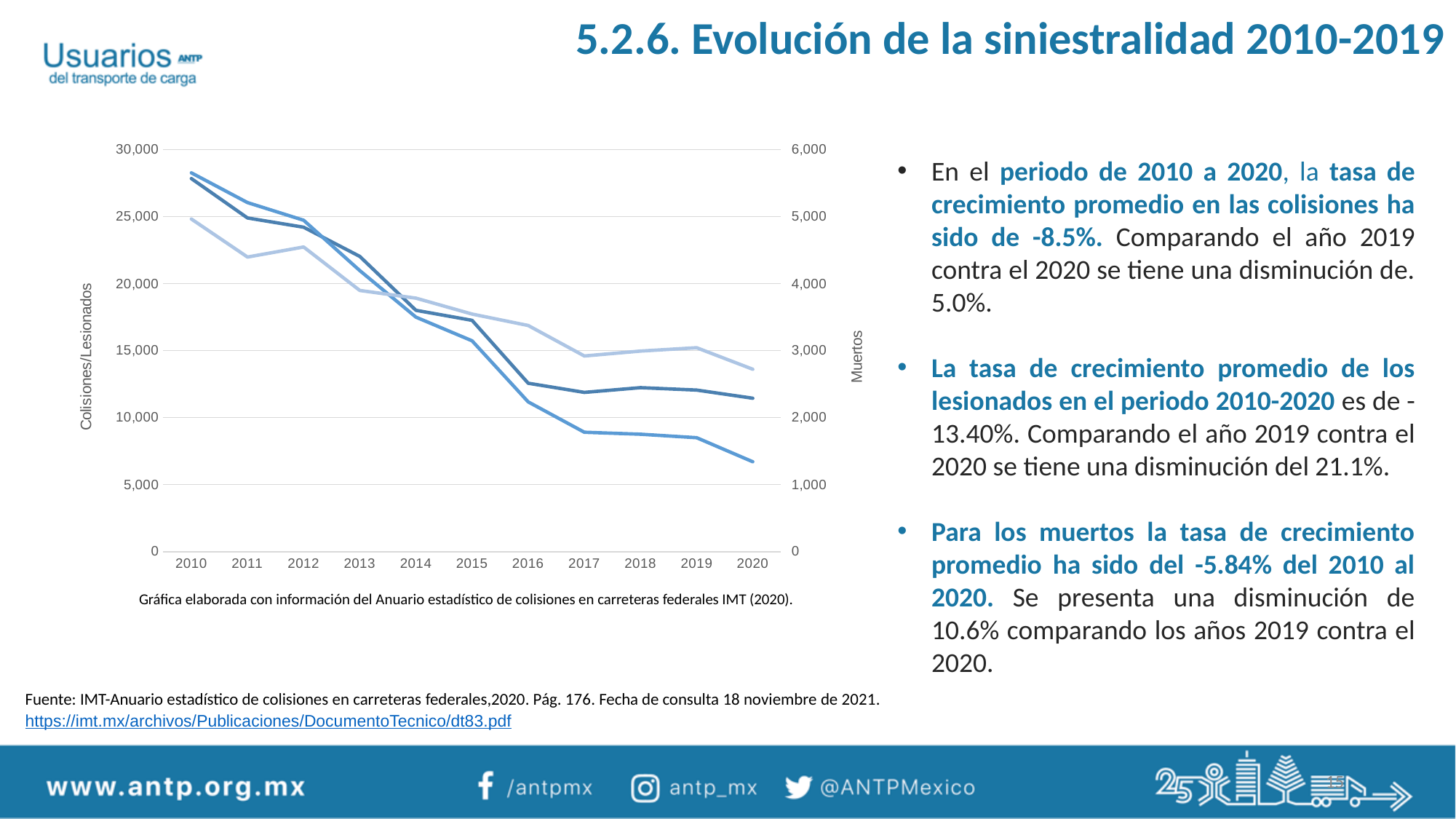
What kind of chart is shown on the slide? line chart In which year does the medium blue line (the lowest line in 2020) reach its lowest value? 2020 Which line is the lowest of the three in 2010? the light blue line Reading against the left axis, is the value of the medium blue line in 2020 greater or less than 10,000? less Reading against the left axis, is the value of the light blue line in 2020 greater or less than 15,000? less Which line is the highest of the three in 2020? the light blue line How many lines are plotted on the chart? 3 In which year does the light blue line reach its highest value? 2010 What is the label of the left vertical axis of the chart? Colisiones/Lesionados What is the label of the right vertical axis of the chart? Muertos How many years are plotted along the x axis of the chart? 11 Do the plotted lines generally rise or fall from 2010 to 2020? fall